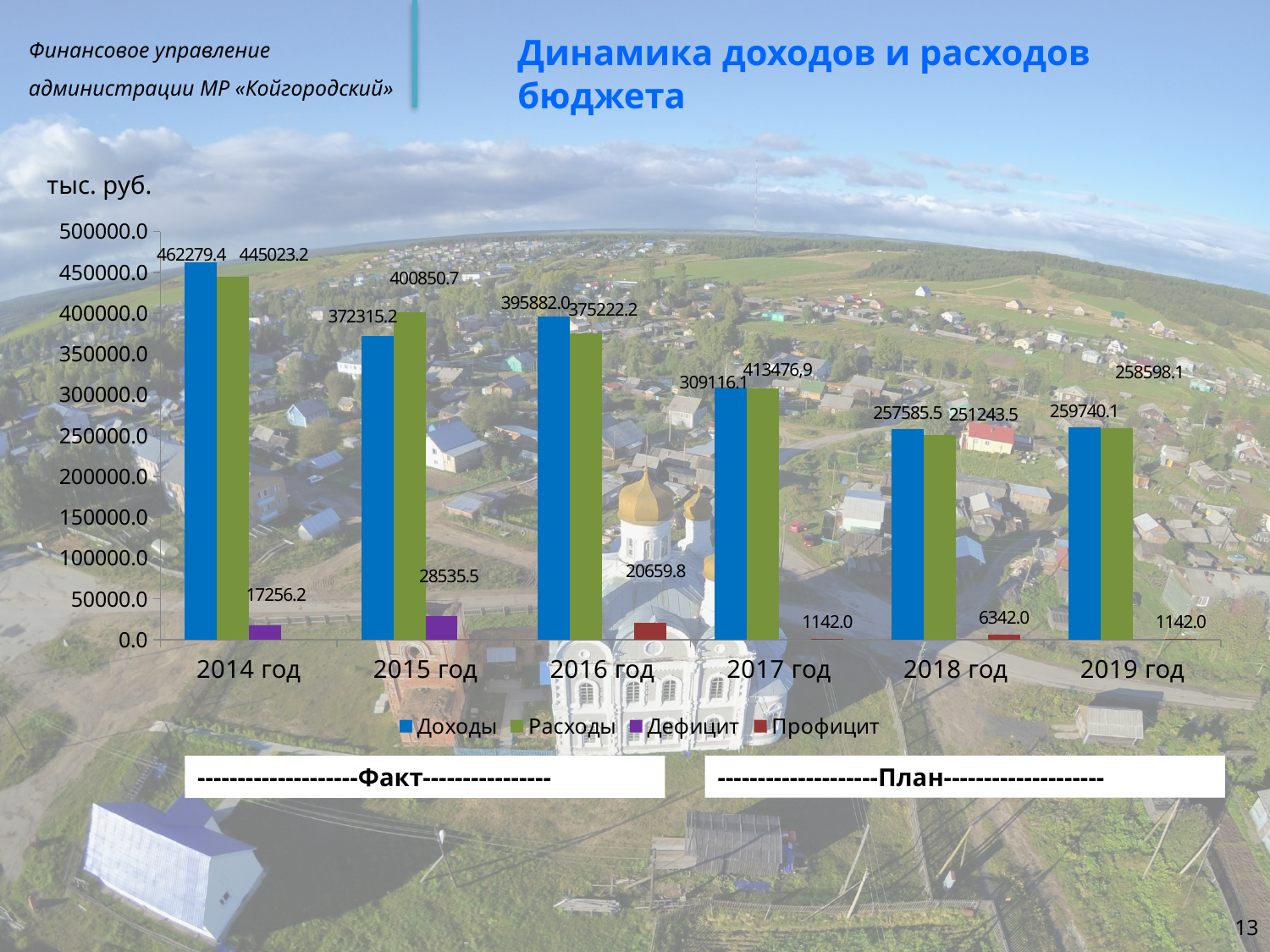
In which year is Доходы the lowest? 2018 год What kind of chart is shown on the slide? bar chart What is the difference between Доходы and Расходы in 2016 год? 20659.8 What is the value of Расходы for 2015 год? 400850.7 What is the value of Дефицит for 2015 год? 28535.5 Is the value of Доходы for 2016 год greater or less than 350000.0? greater In which year is Доходы the highest? 2014 год What is the value of Профицит for 2016 год? 20659.8 In 2015 год, which is larger: Доходы or Расходы? Расходы What is the value of Доходы for 2014 год? 462279.4 How many years are shown on the x axis? 6 How many series does the legend list? 4